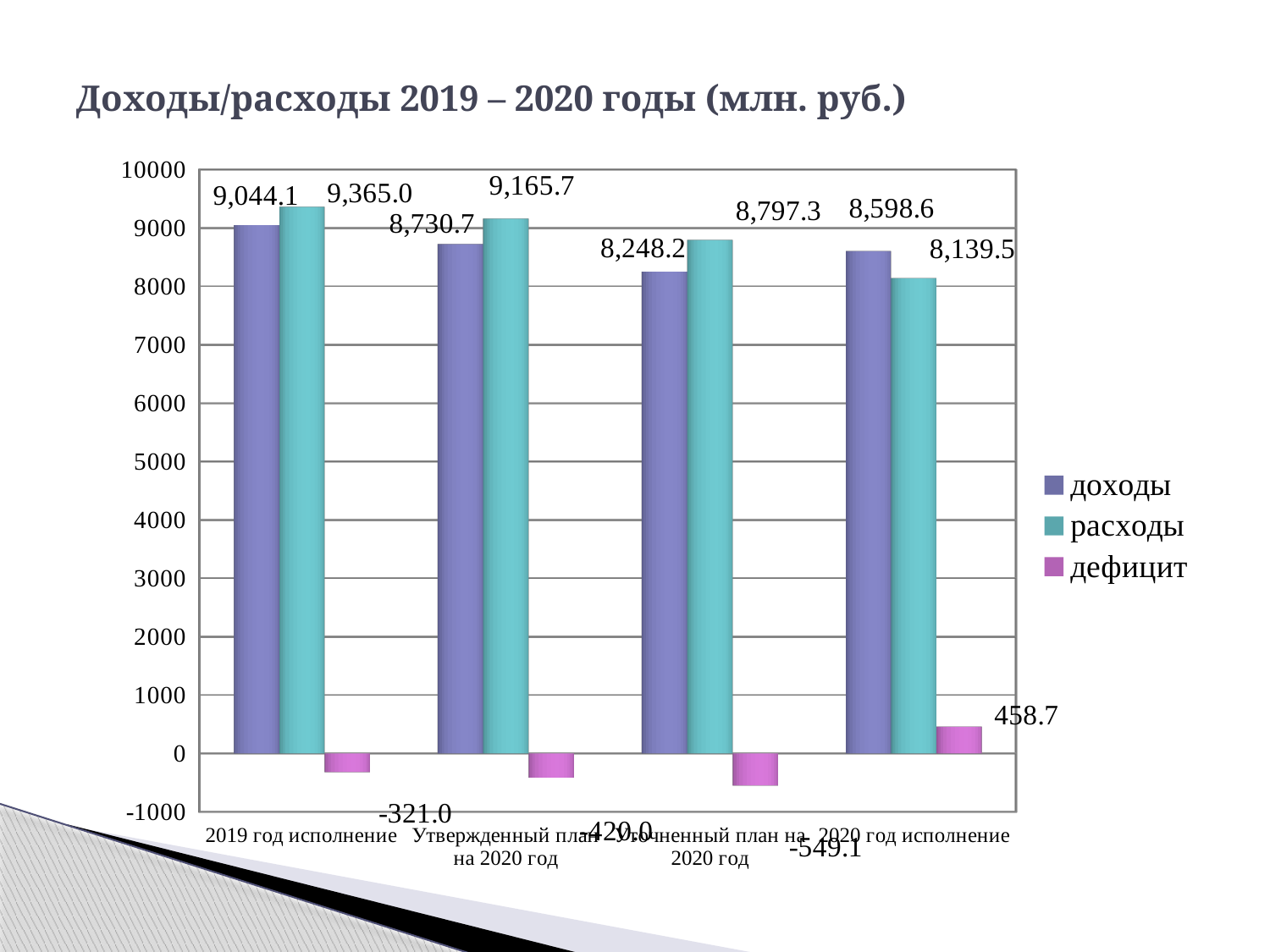
What is the value of дефицит for 2020 год исполнение? 458.7 For 2020 год исполнение, which is larger: доходы or расходы? доходы What type of chart is shown on the slide? bar chart What is the value of расходы for Уточненный план на 2020 год? 8,797.3 What is the title of the chart? Доходы/расходы 2019 – 2020 годы (млн. руб.) What is the value of расходы for Утвержденный план на 2020 год? 9,165.7 What is the difference between расходы and доходы for 2019 год исполнение? 320.9 How many categories are shown on the x axis? 4 Which category has the highest value of расходы? 2019 год исполнение What is the value of доходы for 2019 год исполнение? 9,044.1 How many series does the legend list? 3 Which category has the lowest value of доходы? Уточненный план на 2020 год